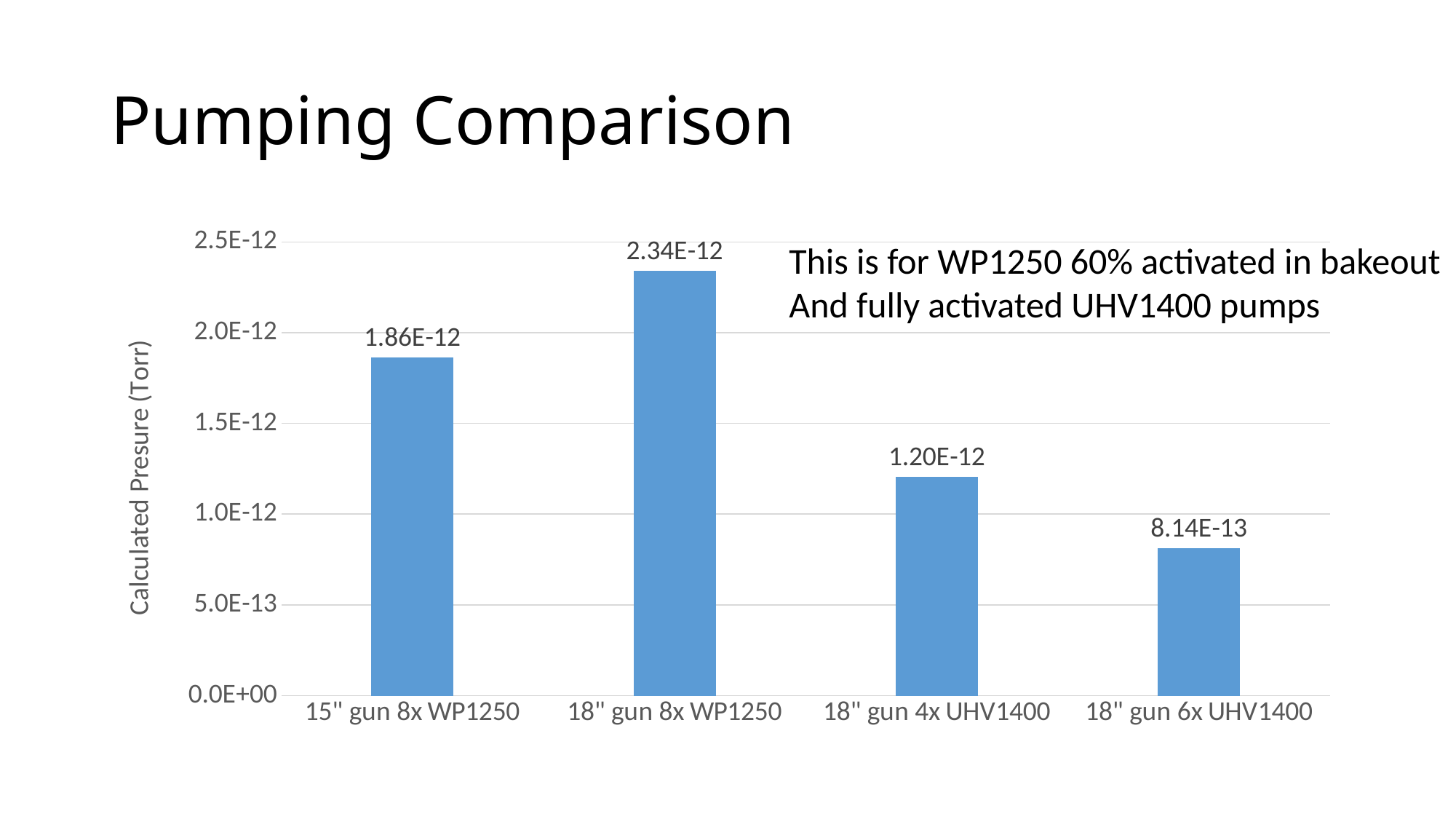
How many configurations are plotted in the chart? 4 What kind of chart is shown on the slide? bar chart What is the label of the vertical axis? Calculated Presure (Torr) Is the value for the 18" gun 6x UHV1400 greater or less than 1.0E-12? less What is the calculated pressure for the 18" gun 4x UHV1400 configuration? 1.20E-12 What is the difference in calculated pressure between the 18" gun 8x WP1250 and the 15" gun 8x WP1250 configurations? 4.80E-13 Which has a higher calculated pressure, the 18" gun 4x UHV1400 or the 18" gun 6x UHV1400? 18" gun 4x UHV1400 Which configuration has the lowest calculated pressure? 18" gun 6x UHV1400 What is the calculated pressure for the 18" gun 6x UHV1400 configuration? 8.14E-13 Which configuration has the highest calculated pressure? 18" gun 8x WP1250 What is the calculated pressure for the 18" gun 8x WP1250 configuration? 2.34E-12 What is the calculated pressure for the 15" gun 8x WP1250 configuration? 1.86E-12